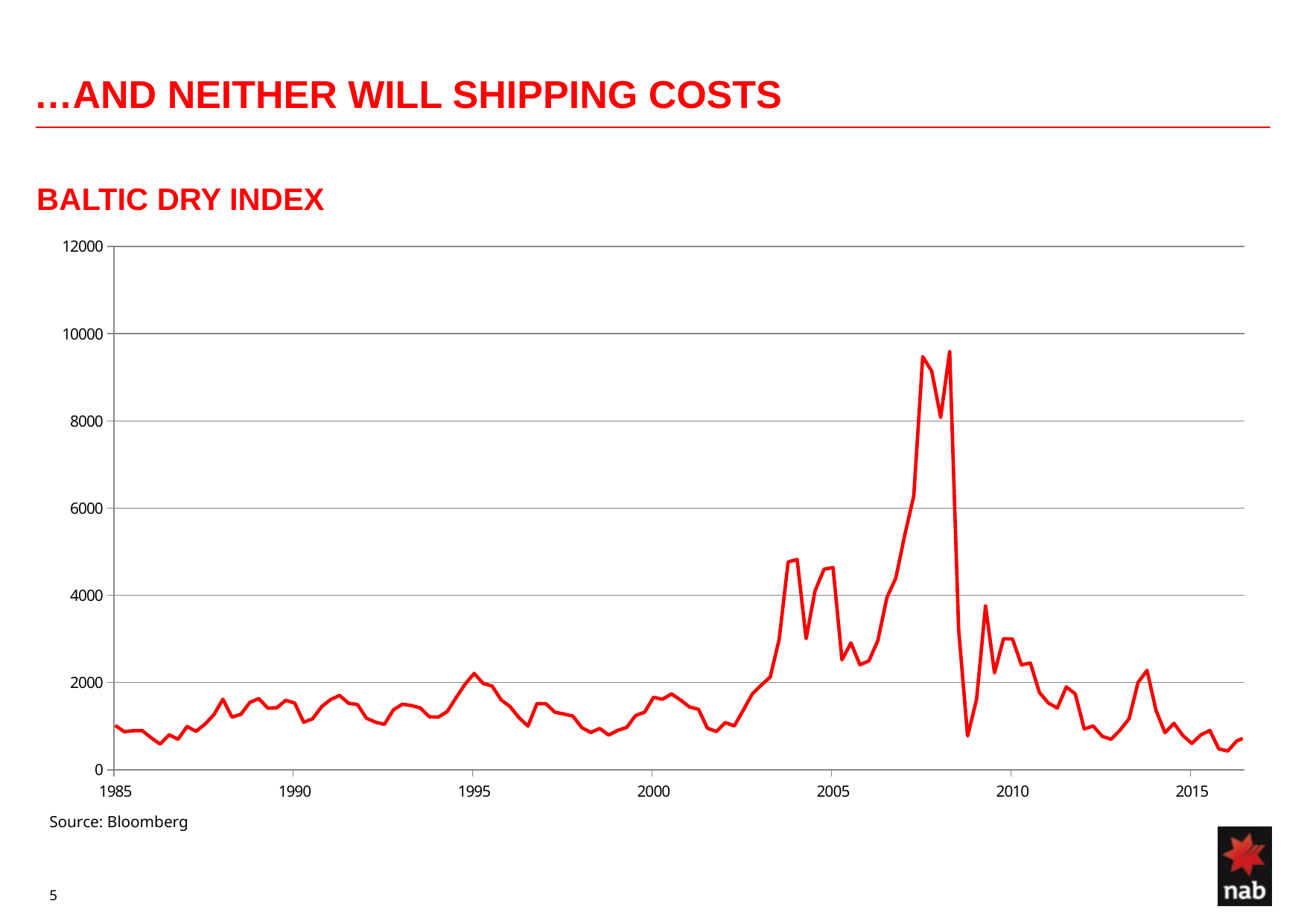
Is the peak of the Baltic Dry Index around 2004 greater or less than 4000? greater Is the value of the Baltic Dry Index in 1985 greater or less than 2000? less Which is larger: the Baltic Dry Index peak around 2008 or its peak around 2004? the peak around 2008 Does the Baltic Dry Index rise or fall between 2005 and its peak around 2008? rise Around which year does the Baltic Dry Index reach its highest value on the chart? 2008 What kind of chart is shown on the slide? line chart What is the highest value shown on the vertical axis of the chart? 12000 Is the peak value of the Baltic Dry Index around 2008 greater or less than 8000? greater How many lines (series) are plotted on the chart? 1 What is the title of the chart? BALTIC DRY INDEX Does the Baltic Dry Index rise or fall between its peak around 2008 and 2009? fall